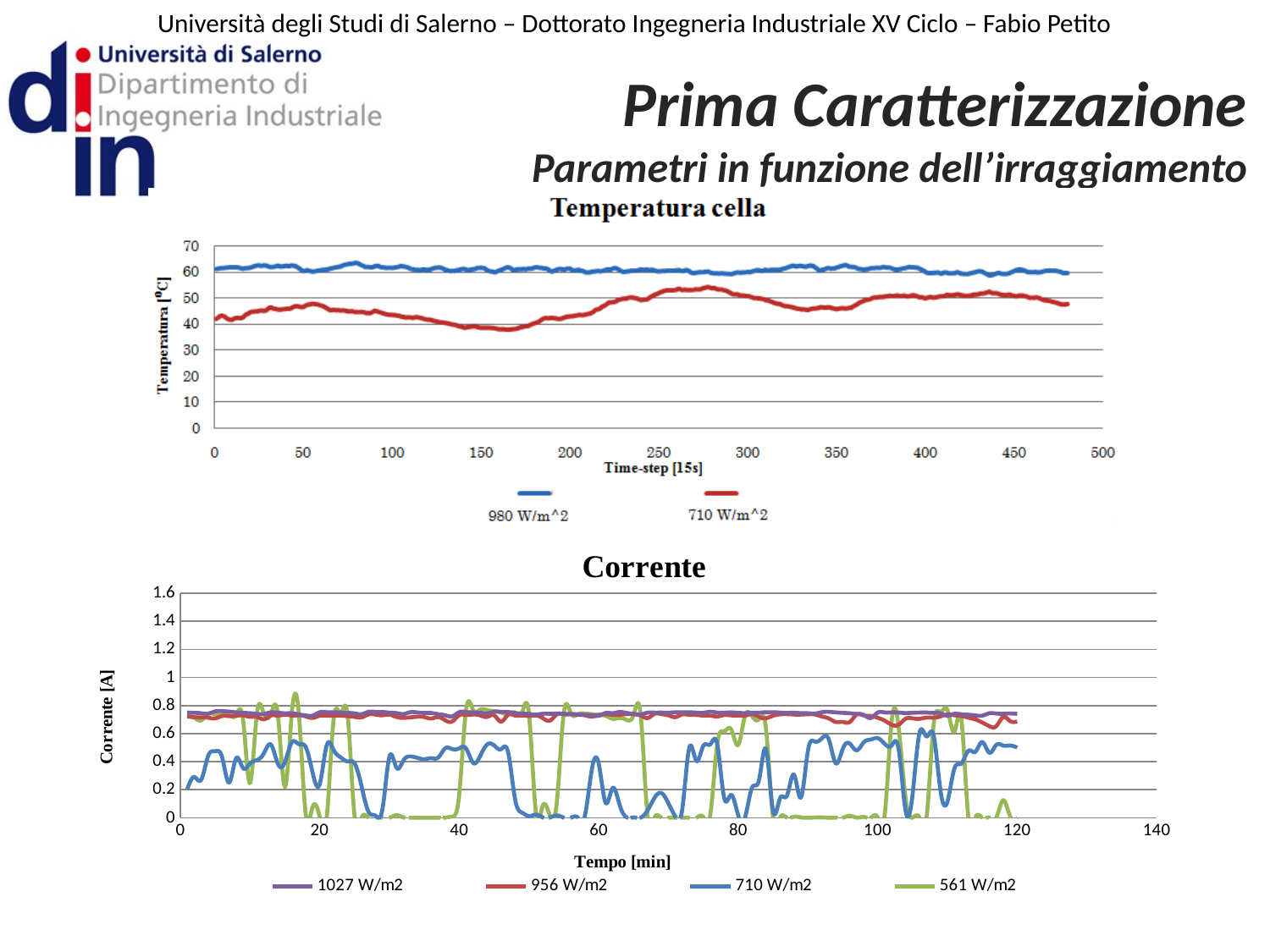
How many series does the legend of the 'Corrente' chart list? 4 What kind of chart is the 'Corrente' chart? line chart In the 'Temperatura cella' chart, which series shows the higher temperature, 980 W/m^2 or 710 W/m^2? 980 W/m^2 In the 'Corrente' chart, which series is higher, 1027 W/m2 or 710 W/m2? 1027 W/m2 What is the y-axis label of the 'Corrente' chart? Corrente [A] What kind of chart is the 'Temperatura cella' chart? line chart In the 'Temperatura cella' chart, is the 710 W/m^2 series greater or less than 60 throughout the plotted range? less In the 'Temperatura cella' chart, is the 980 W/m^2 series greater or less than 50 throughout the plotted range? greater What is the x-axis label of the 'Temperatura cella' chart? Time-step [15s] In the 'Corrente' chart, is the value of the 710 W/m2 series at 60 min greater or less than 0.6? less How many series does the legend of the 'Temperatura cella' chart list? 2